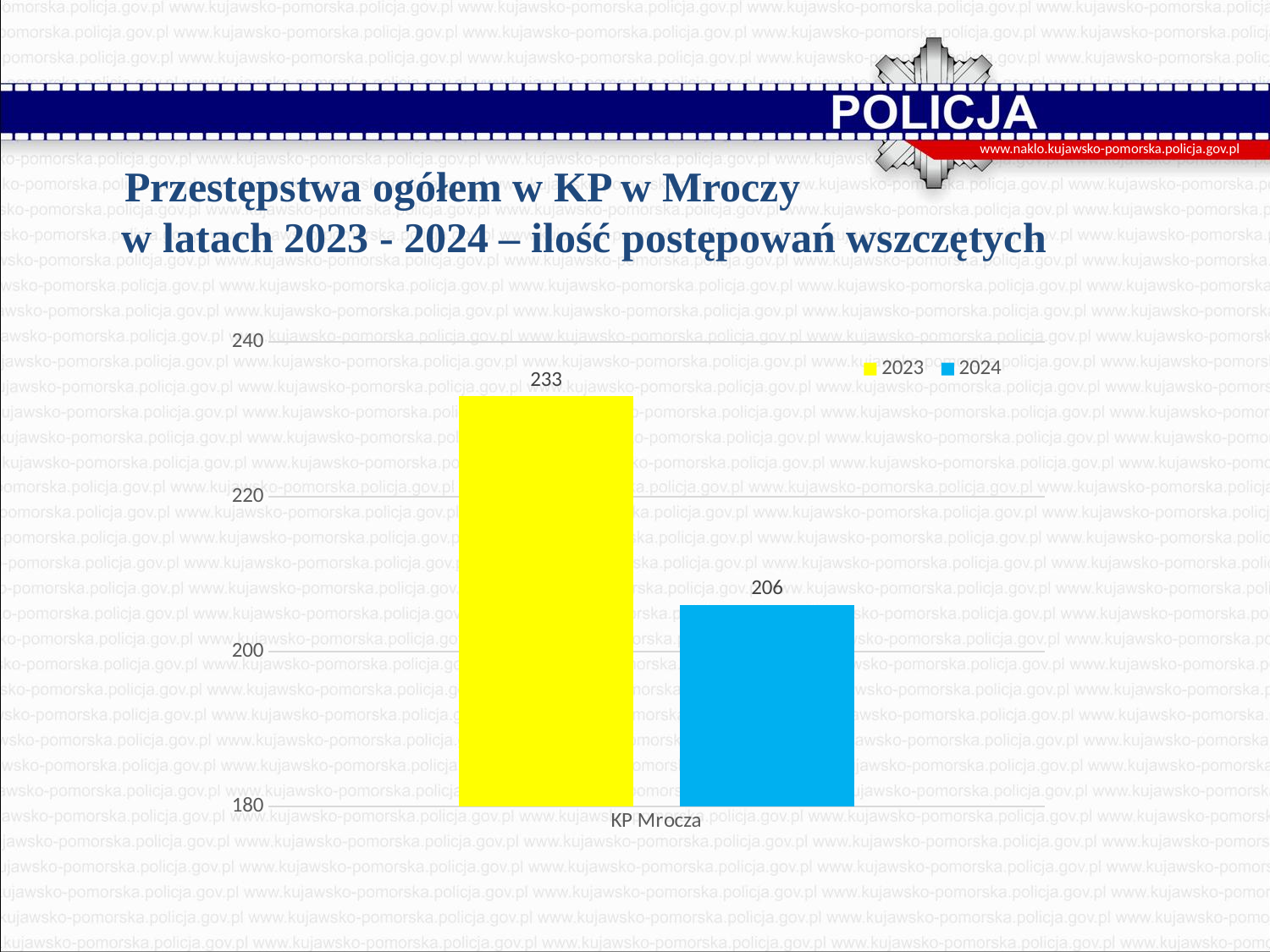
How many series does the legend list? 2 What is the category label on the x axis? KP Mrocza Do the values fall or rise from 2023 to 2024? fall Which series has the lowest value in the chart? 2024 Which year has the higher value, 2023 or 2024? 2023 What kind of chart is shown on the slide? bar chart What colour is the bar for 2024? blue What is the value for 2023 in the chart? 233 Is the value for 2023 greater or less than 220? greater What is the value for 2024 in the chart? 206 What is the difference between the 2023 and 2024 values? 27 Is the value for 2024 greater or less than 220? less